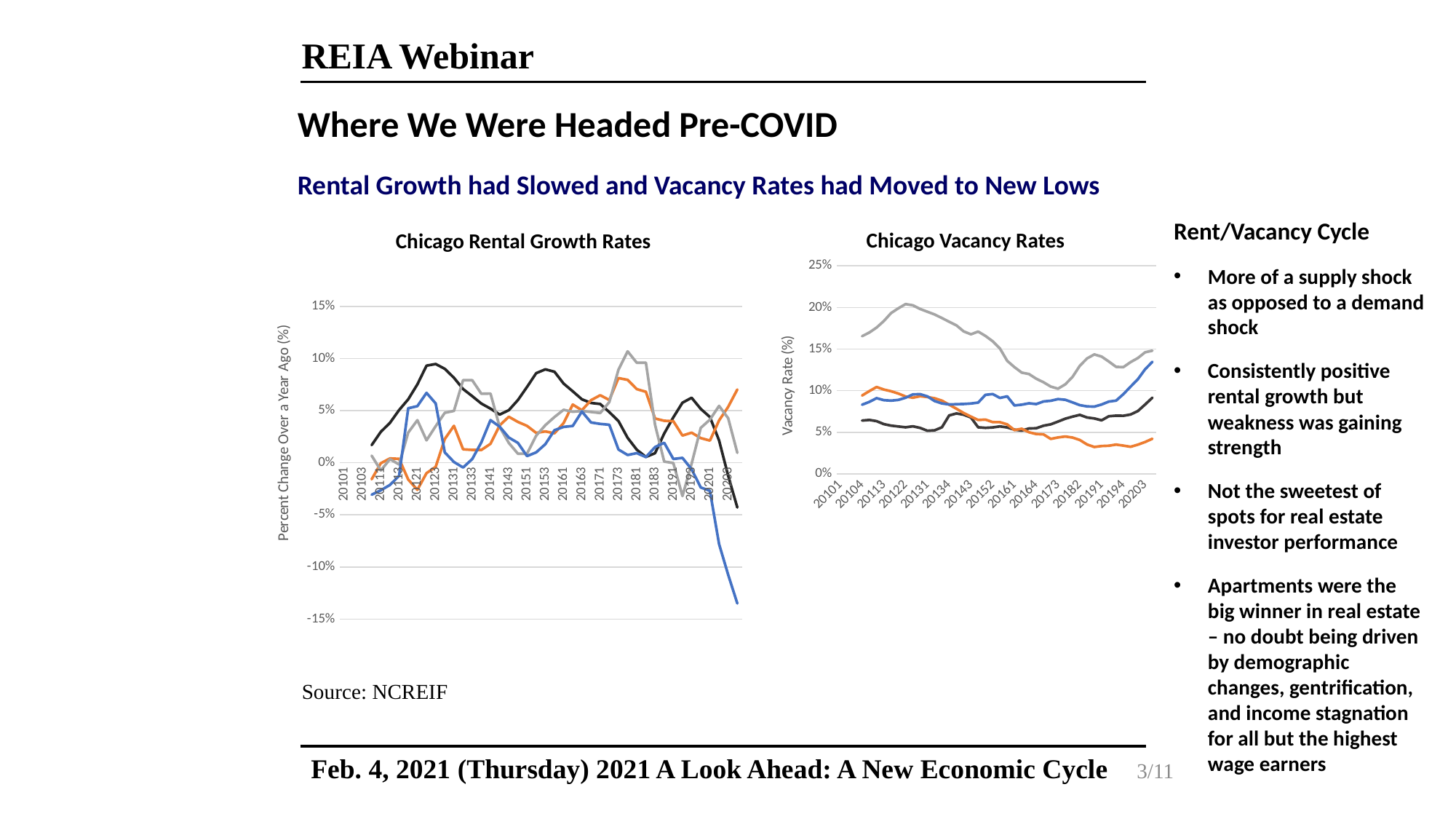
In the "Chicago Rental Growth Rates" chart, is the value of the black line at 20153 greater or less than 5%? greater In the "Chicago Rental Growth Rates" chart, what is the label of the vertical axis? Percent Change Over a Year Ago (%) What kind of chart is the "Chicago Vacancy Rates" chart? line chart In the "Chicago Vacancy Rates" chart, is the value of the gray line at 20101 greater or less than 15%? greater In the "Chicago Vacancy Rates" chart, what is the label of the vertical axis? Vacancy Rate (%) In the "Chicago Vacancy Rates" chart, is the value of the blue line at 20203 greater or less than 10%? greater In the "Chicago Vacancy Rates" chart, does the gray line rise or fall between 20122 and 20173? fall In the "Chicago Vacancy Rates" chart, does the blue line rise or fall between 20182 and 20203? rise In the "Chicago Vacancy Rates" chart, which line is highest at 20101, the gray line or the orange line? gray line What kind of chart is the "Chicago Rental Growth Rates" chart? line chart